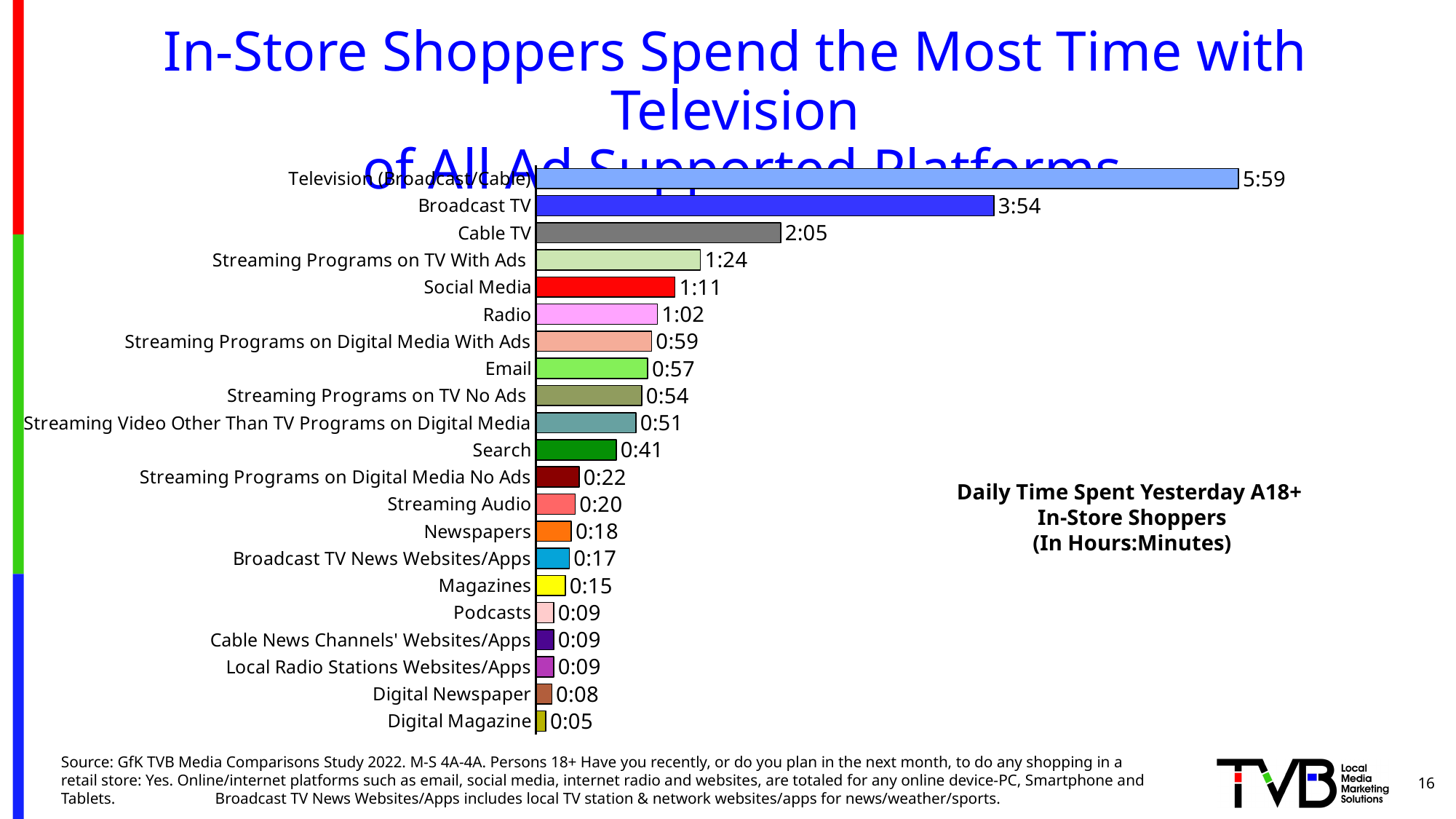
What kind of chart is shown on the slide? Bar chart What is the value for Social Media? 1:11 Which is larger, Email or Streaming Programs on TV No Ads? Email Which category has the highest value? Television (Broadcast/Cable) What is the difference between Broadcast TV and Cable TV? 1:49 How many categories are shown in the chart? 21 In what units are the values in the chart expressed, according to the chart's title? Hours:Minutes What is the value for Search? 0:41 What is the value for Broadcast TV? 3:54 What is the value for Digital Magazine? 0:05 Which category has the lowest value? Digital Magazine What is the difference between Social Media and Radio? 0:09